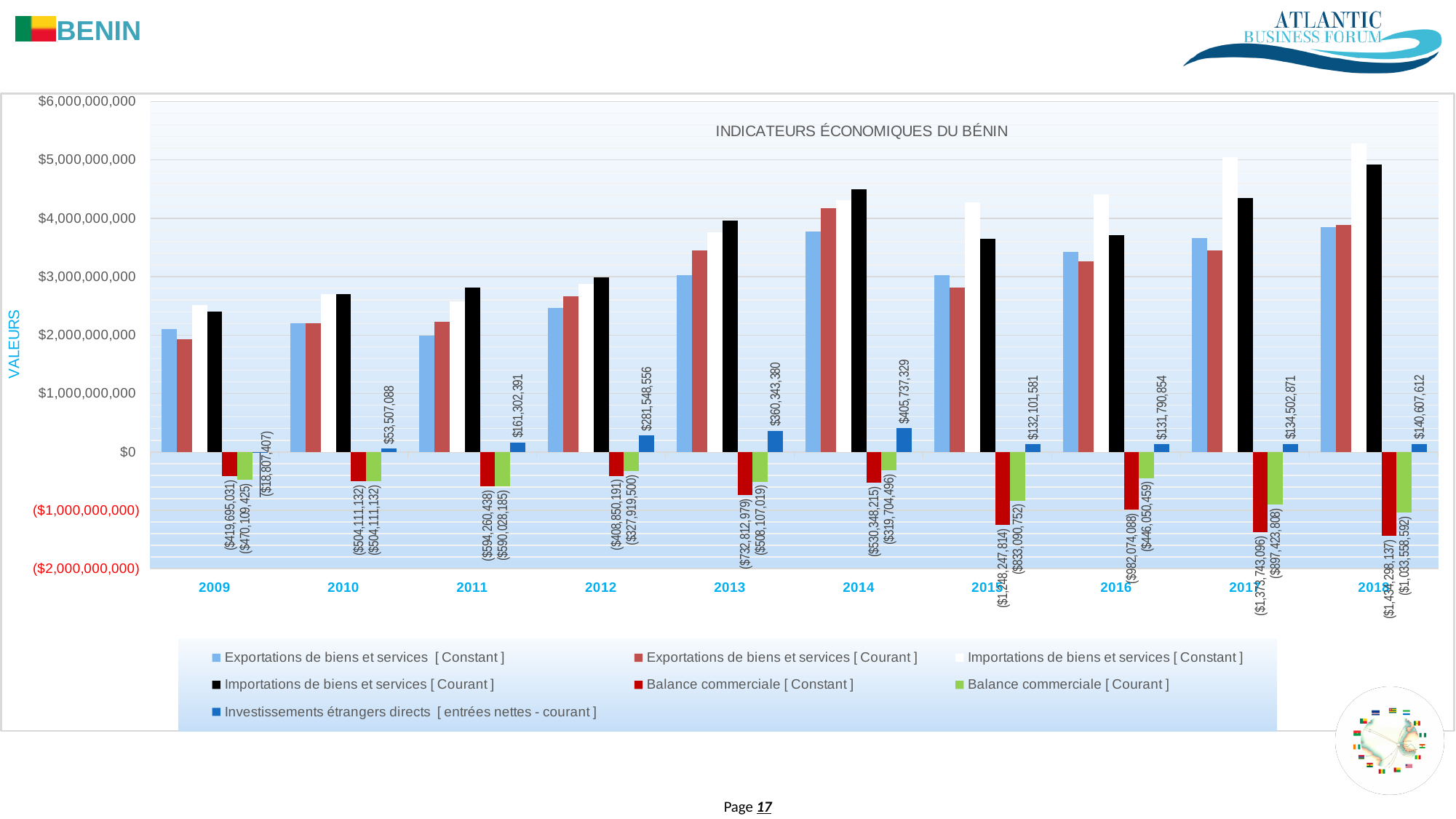
Does Importations de biens et services [ Courant ] generally rise or fall from 2009 to 2018? rise How many years are shown on the x axis of the chart? 10 What is the difference between Investissements étrangers directs in 2014 and in 2013? $45,393,949 What is the value of Balance commerciale [ Courant ] in 2018? ($1,033,558,592) What is the value of Balance commerciale [ Constant ] in 2013? ($732,812,979) What is the value of Investissements étrangers directs in 2014? $405,737,329 In which year is Investissements étrangers directs highest? 2014 Which is larger, Investissements étrangers directs in 2014 or in 2015? 2014 How many series does the legend list? 7 What type of chart is shown on the slide? Bar chart What is the title of the chart? INDICATEURS ÉCONOMIQUES DU BÉNIN Is the value for Importations de biens et services [ Courant ] in 2018 greater or less than $4,000,000,000? greater